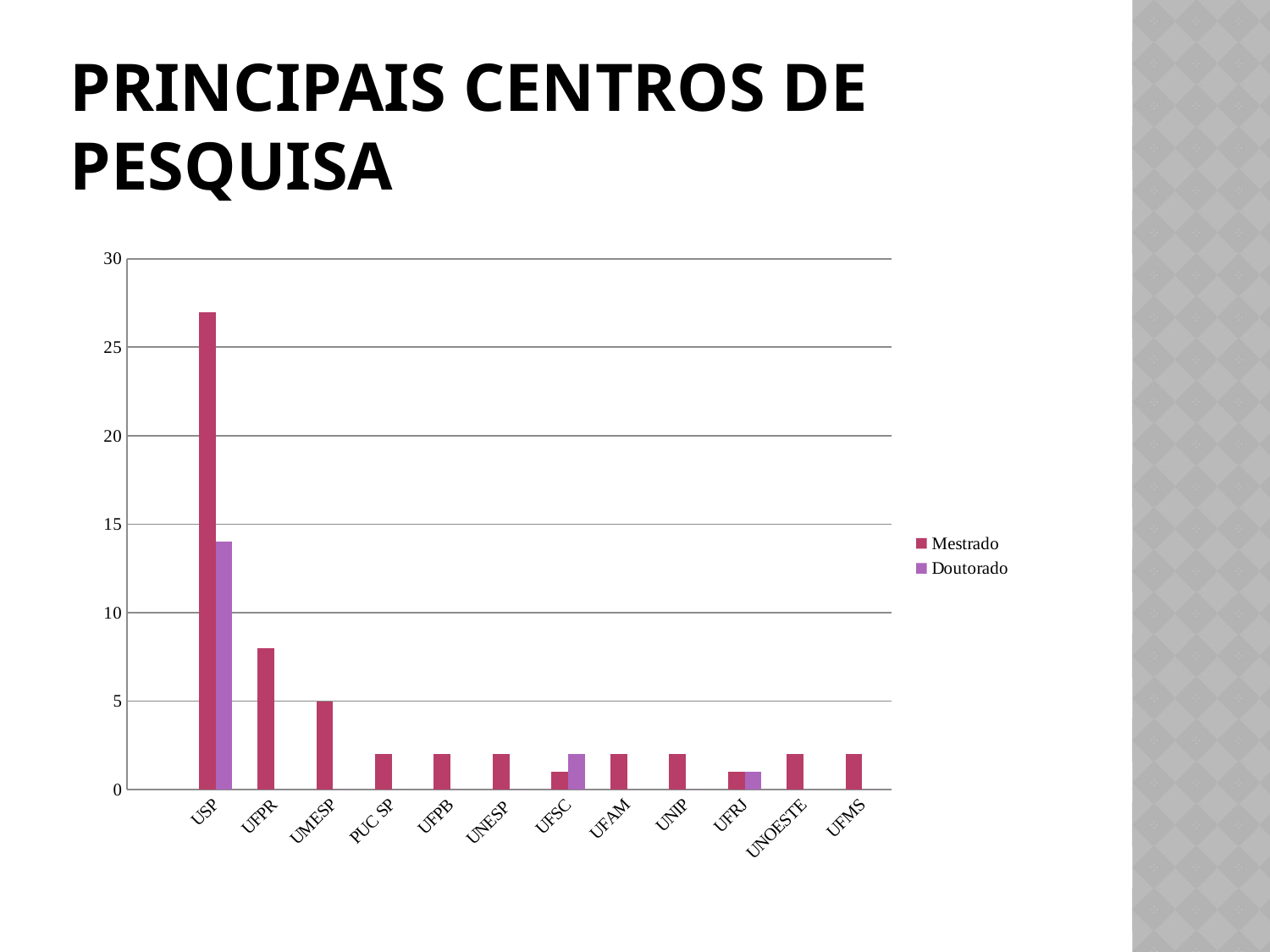
What kind of chart is shown on the slide? bar chart What are the two series named in the legend? Mestrado and Doutorado Which institution has the highest Doutorado value? USP Is the Doutorado value for USP greater or less than 15? less Which has the larger Mestrado value, UFPR or UMESP? UFPR Is the Mestrado value for UFPR greater or less than 10? less Is the Mestrado value for USP greater or less than 25? greater How many series does the legend list? 2 Which institution has the highest Mestrado value? USP How many institutions are shown on the x axis? 12 What is the Mestrado value for UMESP? 5 For USP, which is larger, the Mestrado value or the Doutorado value? Mestrado